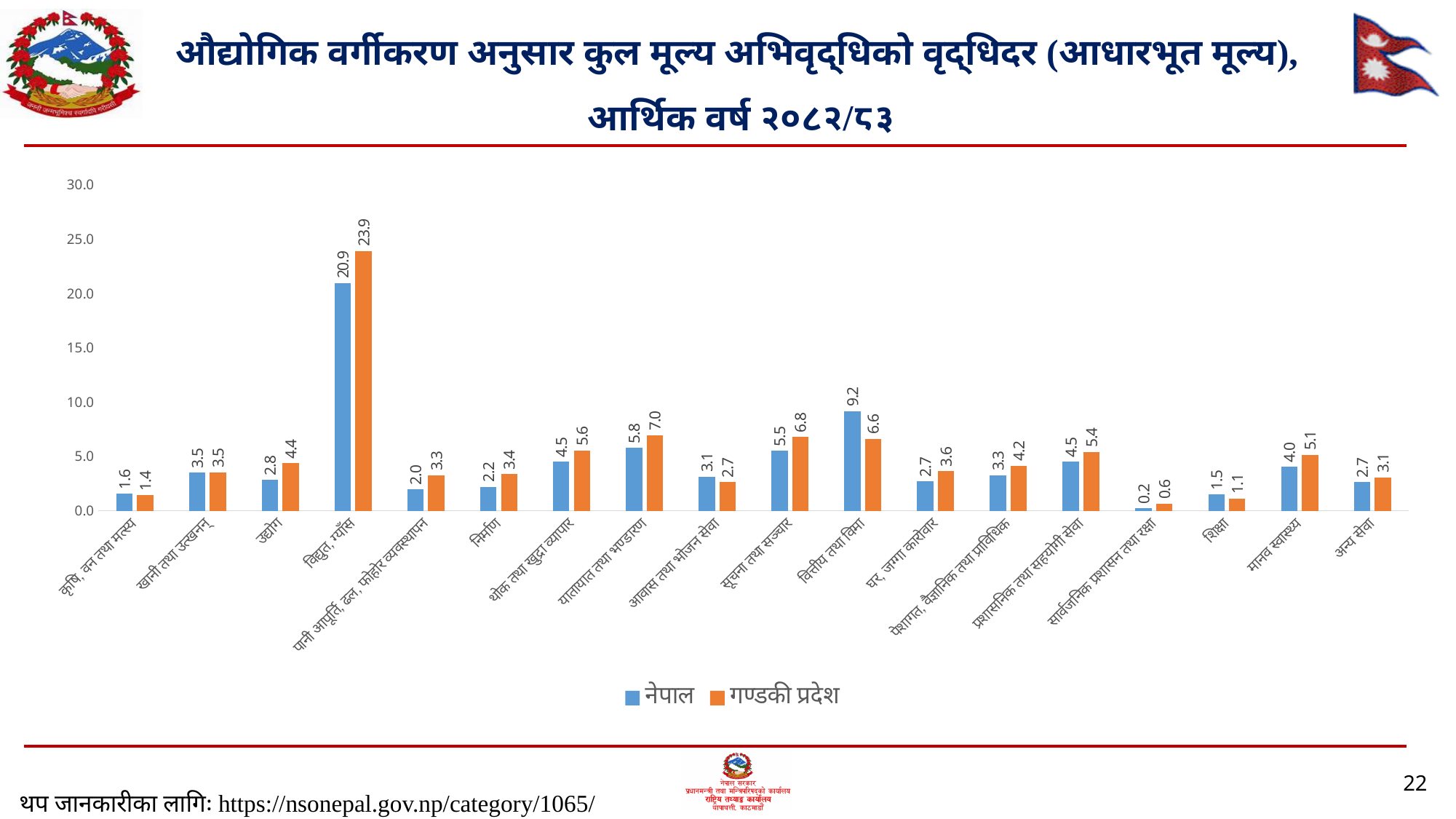
How many series does the legend list? 2 What is the difference between the गण्डकी प्रदेश and नेपाल values in the विद्युत, ग्याँस category? 3.0 In the वित्तीय तथा बिमा category, which series has the larger value, नेपाल or गण्डकी प्रदेश? नेपाल How many categories are shown on the x axis of the chart? 18 Which category has the highest value for गण्डकी प्रदेश? विद्युत, ग्याँस Which colour represents गण्डकी प्रदेश in the chart? Orange What is the value for गण्डकी प्रदेश in the यातायात तथा भण्डारण category? 7.0 What is the value for नेपाल in the सार्वजनिक प्रशासन तथा रक्षा category? 0.2 What is the value for नेपाल in the विद्युत, ग्याँस category? 20.9 In the मानव स्वास्थ्य category, which series has the larger value, नेपाल or गण्डकी प्रदेश? गण्डकी प्रदेश What kind of chart is shown on the slide? Bar chart Which category has the lowest value for नेपाल? सार्वजनिक प्रशासन तथा रक्षा